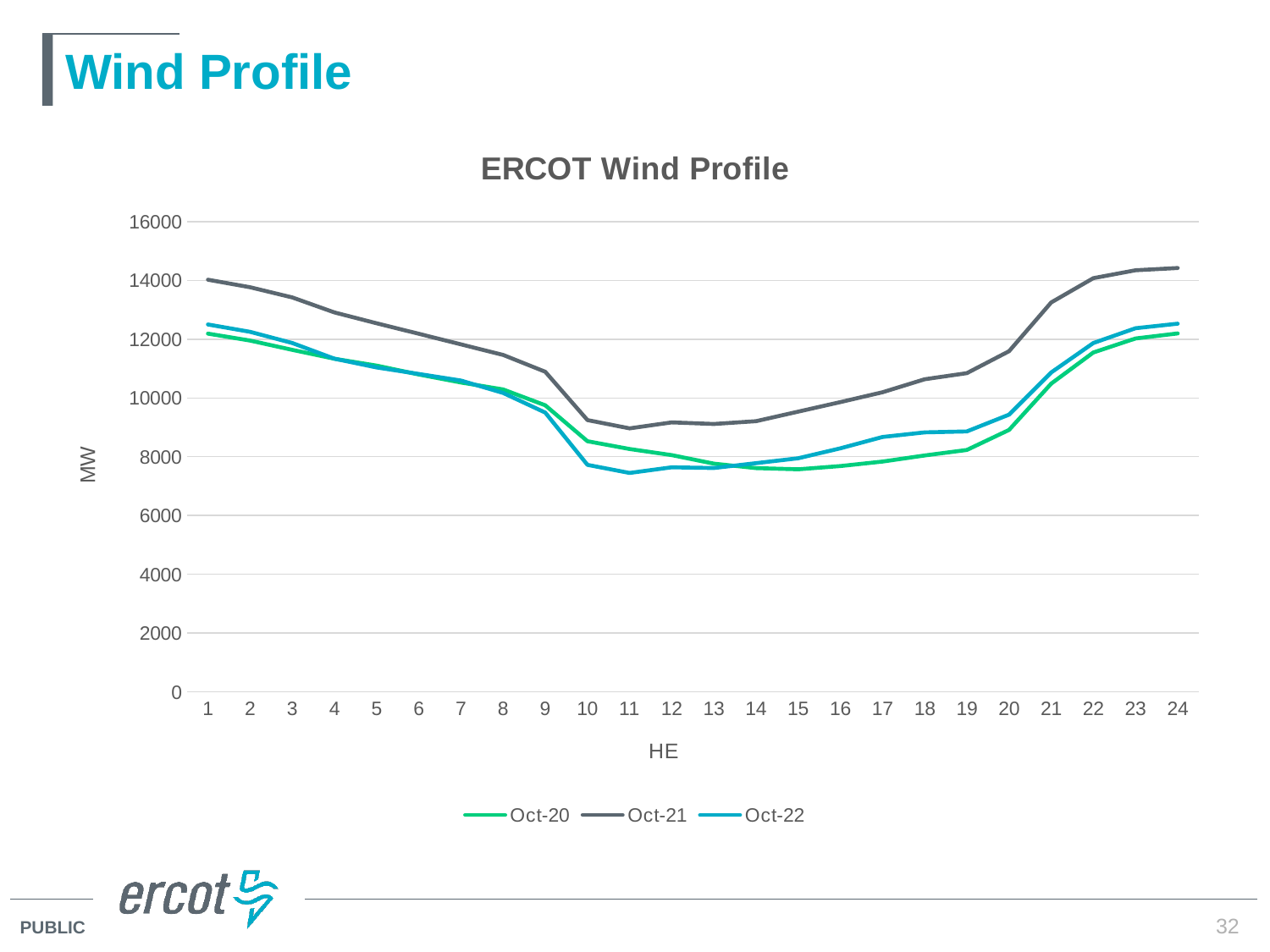
How many hours (HE values) are plotted along the x axis? 24 Is the Oct-22 value at HE 1 greater or less than 12000? greater Which series has the highest value at HE 12? Oct-21 What is the title of the chart? ERCOT Wind Profile Is the Oct-21 value at HE 11 greater or less than 10000? less What type of chart is shown on the slide? Line chart At HE 18, which is larger: the Oct-22 value or the Oct-20 value? Oct-22 Is the Oct-20 value at HE 15 greater or less than 8000? less Does the Oct-21 series rise or fall from HE 1 to HE 11? Fall What is the label on the y axis? MW Which series has the lowest value at HE 11? Oct-22 How many series does the legend list? 3